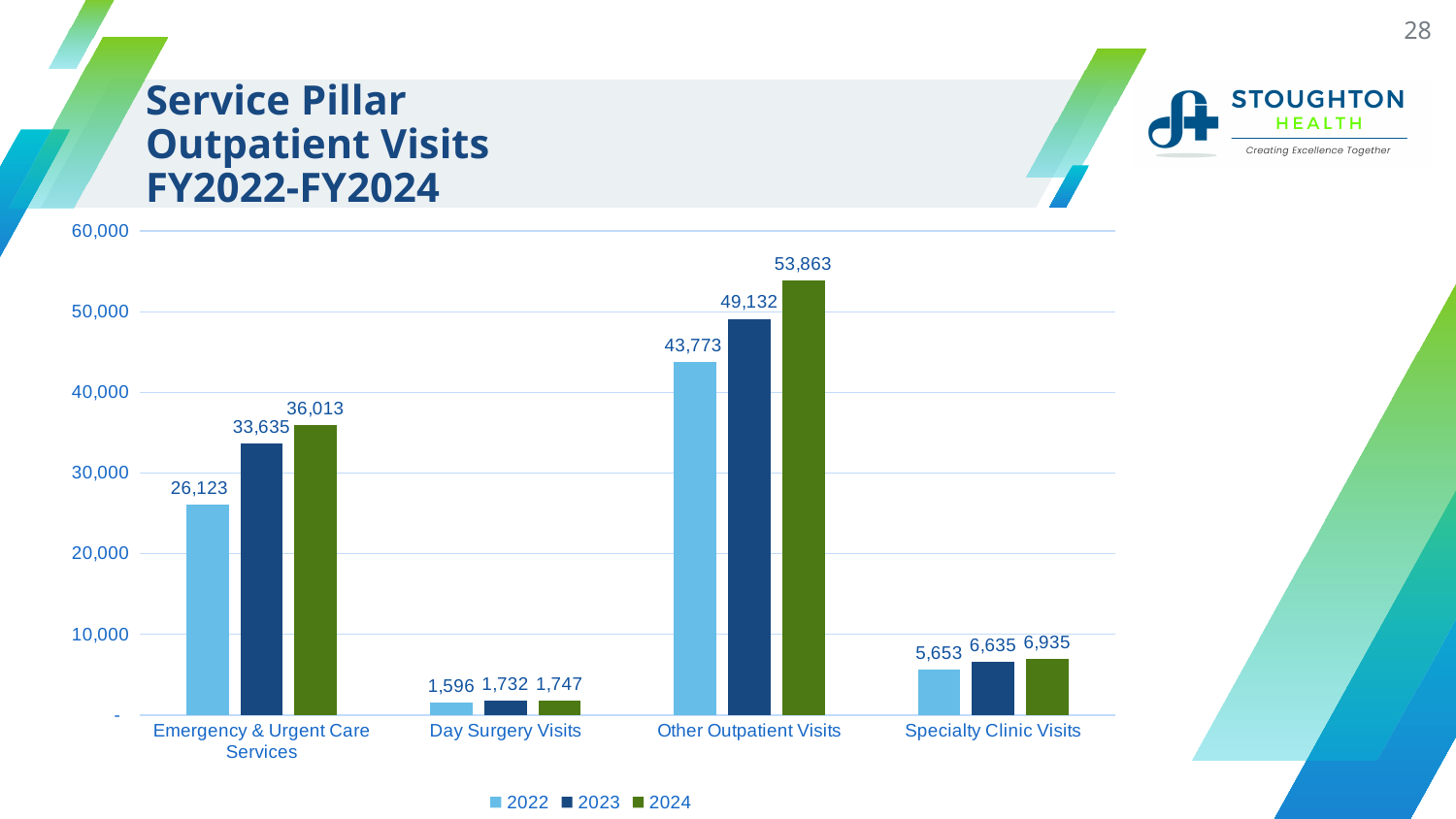
Which was larger: Specialty Clinic Visits in 2023 or Day Surgery Visits in 2024? Specialty Clinic Visits in 2023 By how much did Other Outpatient Visits increase from 2022 to 2024? 10,090 What was the number of Day Surgery Visits in 2023? 1,732 What is the difference between Emergency & Urgent Care Services visits in 2023 and 2022? 7,512 What was the number of Emergency & Urgent Care Services visits in 2022? 26,123 Did Emergency & Urgent Care Services visits rise or fall from 2022 to 2024? rise How many series does the legend list? 3 Which category had the lowest number of visits in 2022? Day Surgery Visits Which category had the highest number of visits in 2024? Other Outpatient Visits What was the number of Other Outpatient Visits in 2024? 53,863 How many categories are shown on the x axis? 4 What was the number of Specialty Clinic Visits in 2024? 6,935